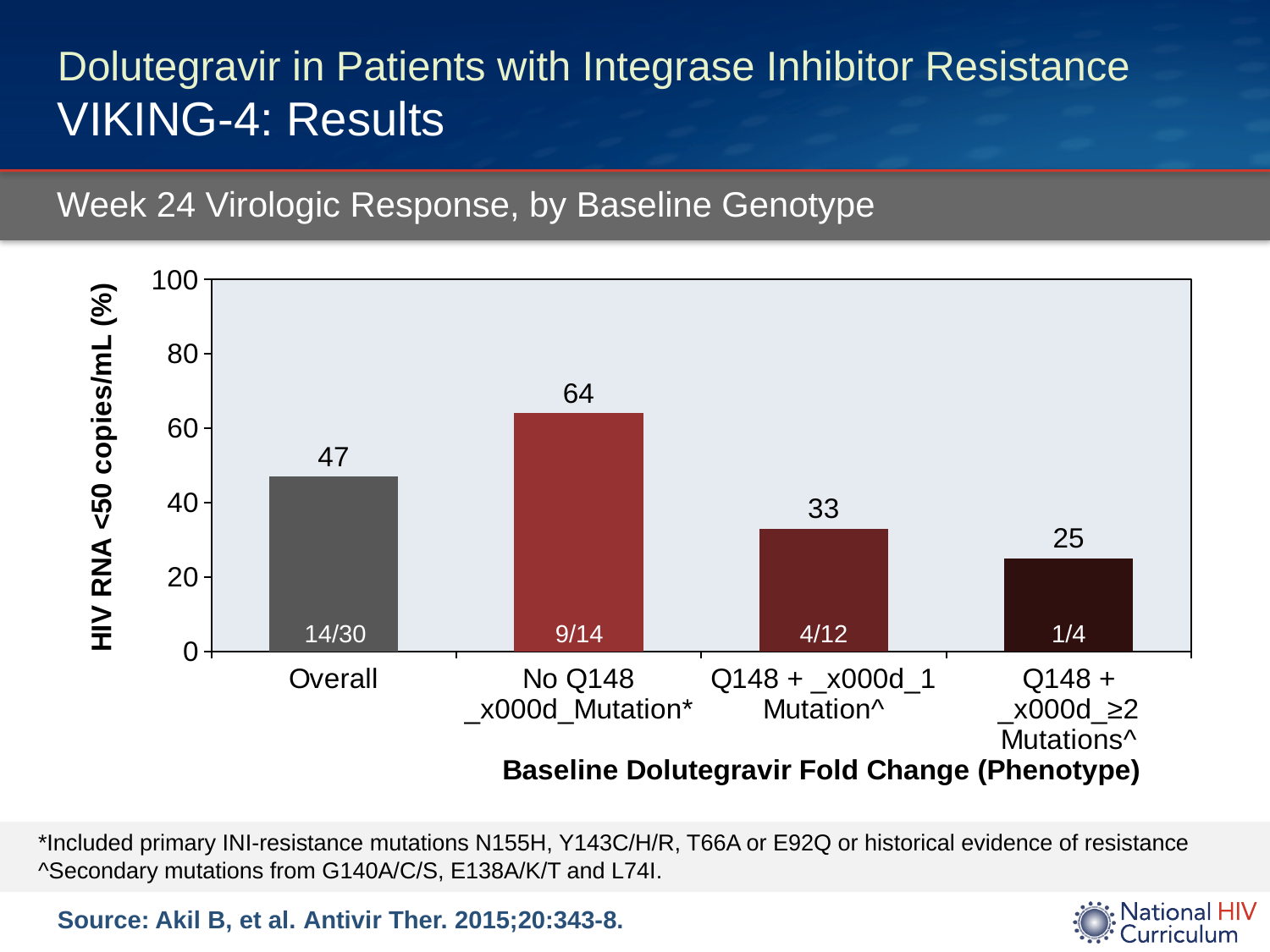
What is the label of the y axis of the chart? HIV RNA <50 copies/mL (%) What is the Week 24 virologic response value shown for the Overall group? 47 What fraction is printed inside the bar for the Q148 + 1 Mutation group? 4/12 Which is larger, the value for the Overall group or the value for the Q148 + 1 Mutation group? Overall What is the difference between the values for the No Q148 Mutation group and the Overall group? 17 What is the difference between the values for the Q148 + 1 Mutation group and the Q148 + ≥2 Mutations group? 8 What fraction is printed inside the bar for the Q148 + ≥2 Mutations group? 1/4 What value is shown above the bar for the No Q148 Mutation group? 64 Which group has the lowest percentage with HIV RNA <50 copies/mL? Q148 + ≥2 Mutations Which group has the highest percentage with HIV RNA <50 copies/mL? No Q148 Mutation What kind of chart is shown on the slide? Bar chart How many groups are shown on the x axis of the chart? 4